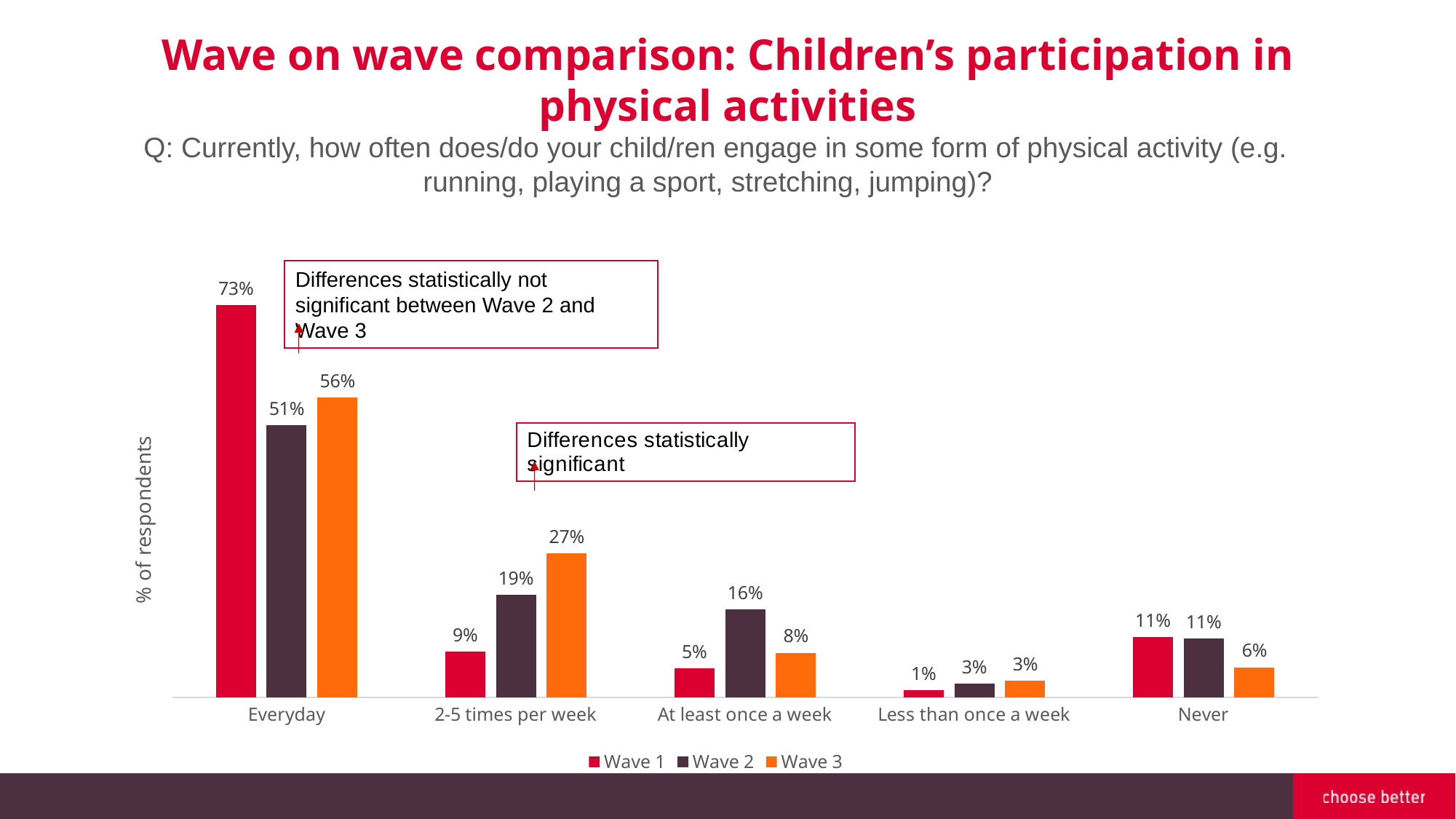
What is the Wave 3 value for 2-5 times per week? 27% What kind of chart is shown on the slide? Bar chart Which category has the lowest Wave 1 value? Less than once a week What is the Wave 3 value for Never? 6% What is the Wave 2 value for At least once a week? 16% Which category has the highest Wave 2 value? Everyday How many series does the legend list? 3 What is the label on the vertical axis? % of respondents What is the difference between the Wave 1 and Wave 2 values for Everyday? 22% What is the Wave 1 value for Everyday? 73% How many categories are shown on the x axis? 5 Which is larger for At least once a week: Wave 1 or Wave 3? Wave 3